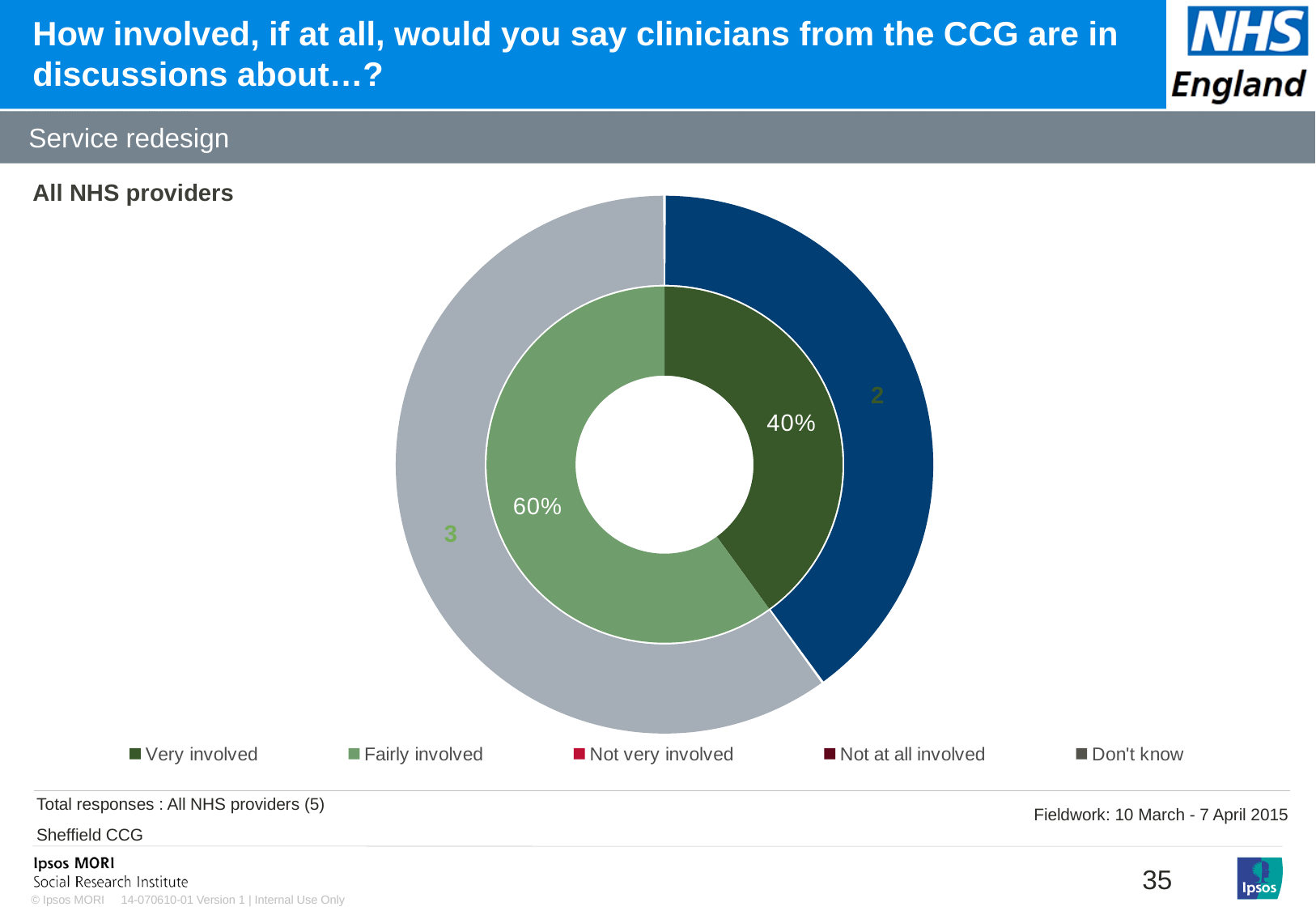
How many respondents are shown in the outer ring for the 'Very involved' segment? 2 How many entries does the legend list? 5 What is the total number of responses stated for All NHS providers? 5 What is the difference in percentage points between 'Fairly involved' and 'Very involved'? 20 percentage points What kind of chart is shown on the slide? Doughnut chart What percentage of All NHS providers said clinicians from the CCG are 'Very involved' in discussions about service redesign? 40% Which response category has the largest share in the inner ring of the chart? Fairly involved Which response category has the smallest share among those shown in the inner ring of the chart? Very involved How many respondents are shown in the outer ring for the 'Fairly involved' segment? 3 Which is larger, the share for 'Very involved' or the share for 'Fairly involved'? Fairly involved What percentage of All NHS providers said clinicians from the CCG are 'Fairly involved' in discussions about service redesign? 60% What is the subheading of the slide describing the topic of the chart? Service redesign